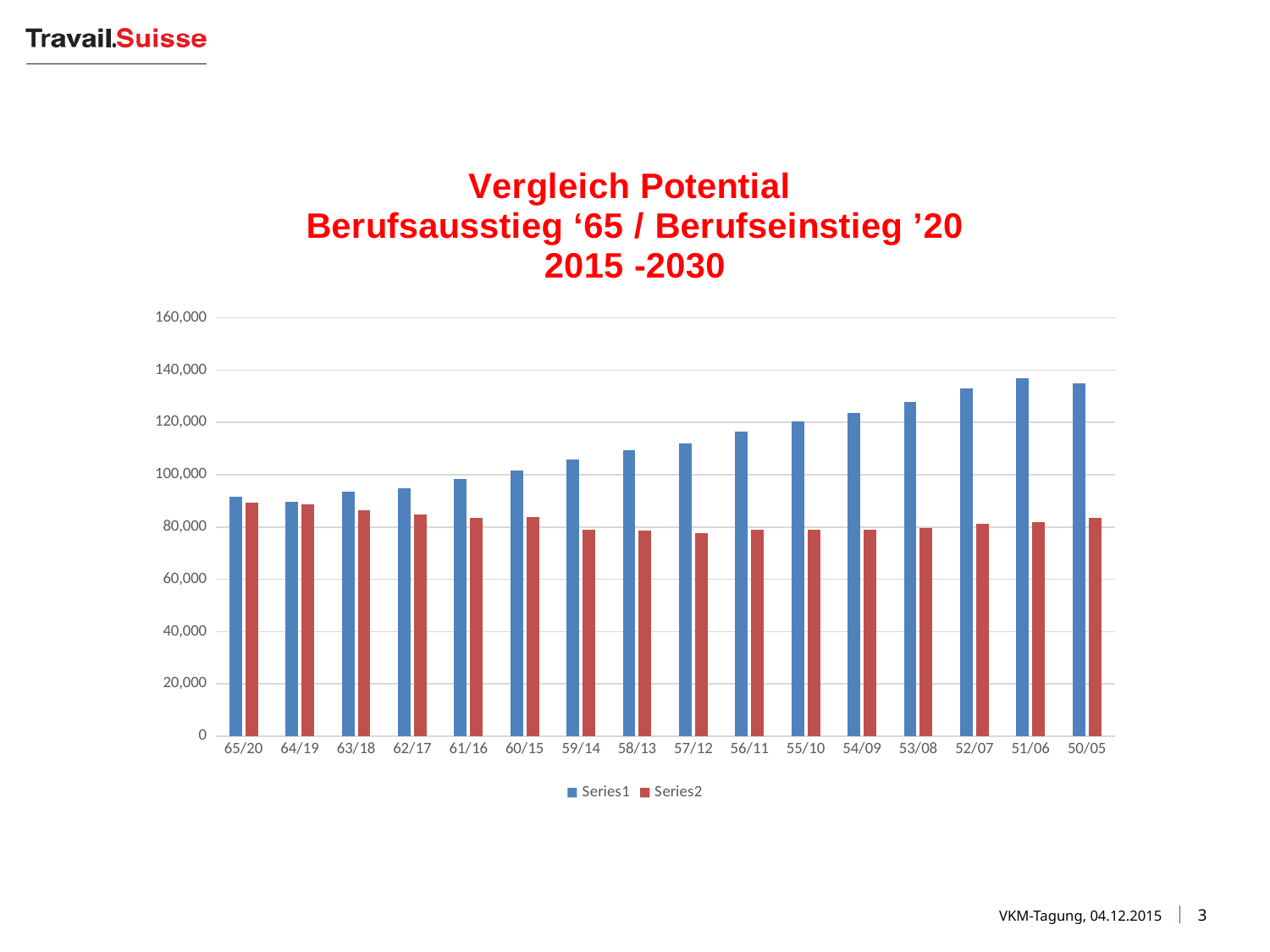
Which is larger at 50/05, Series1 or Series2? Series1 Is the Series2 value for 65/20 greater or less than 80,000? greater Is the Series1 value for 50/05 greater or less than 120,000? greater What are the two entries listed in the legend? Series1 and Series2 How many categories are shown on the x axis? 16 Is the Series1 value for 56/11 greater or less than 100,000? greater Do the Series1 values generally rise or fall from left to right along the x axis? rise How many series does the legend list? 2 Which Series1 value is larger, 50/05 or 65/20? 50/05 What kind of chart is shown on the slide? bar chart